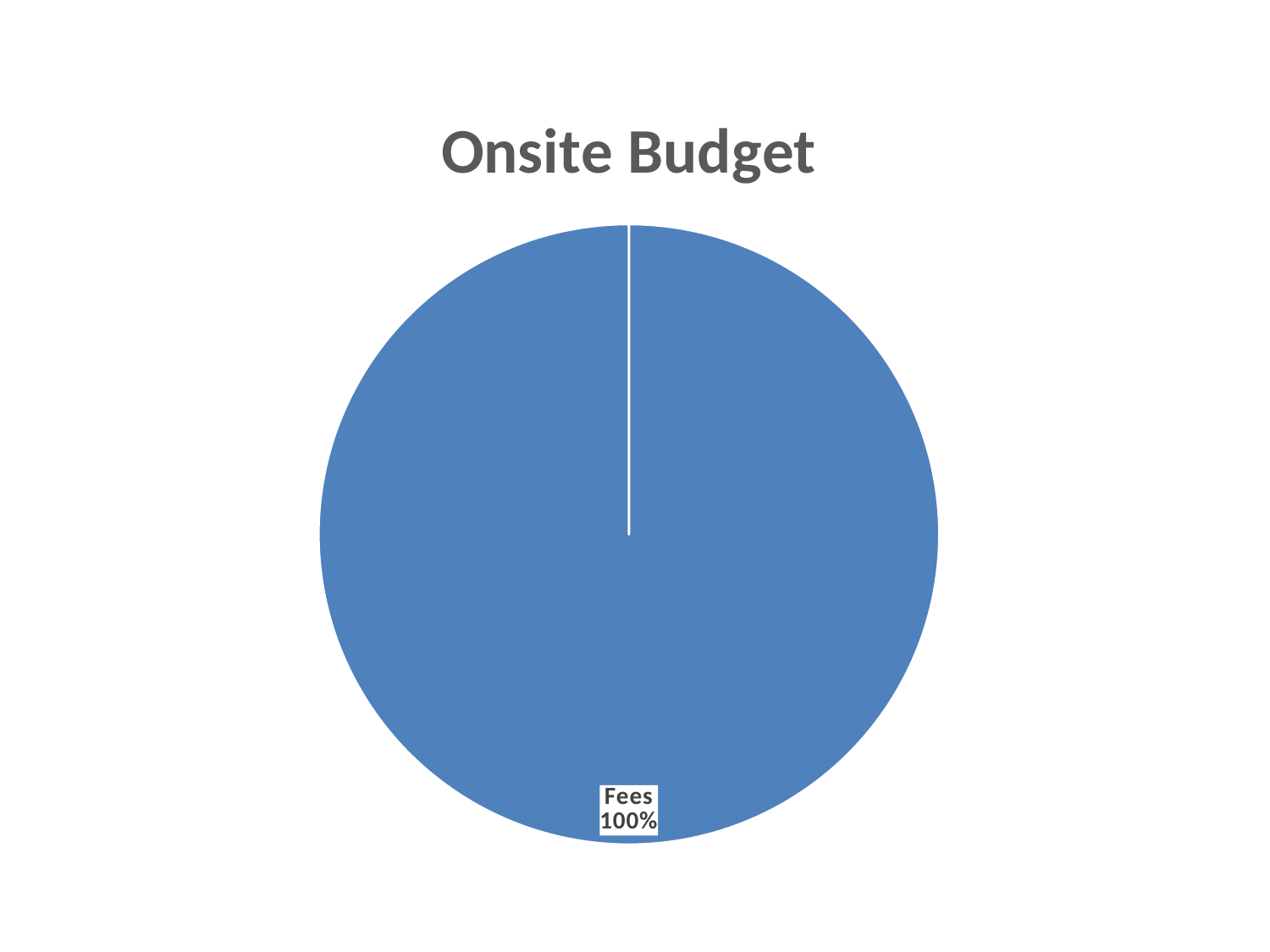
What share of the pie does Fees account for? 100% How many slices does the pie chart have? 1 What colour is the Fees slice? blue What is the value shown for Fees? 100% What is the title of the chart? Onsite Budget What kind of chart is shown on the slide? pie chart Which category is the largest slice of the pie? Fees